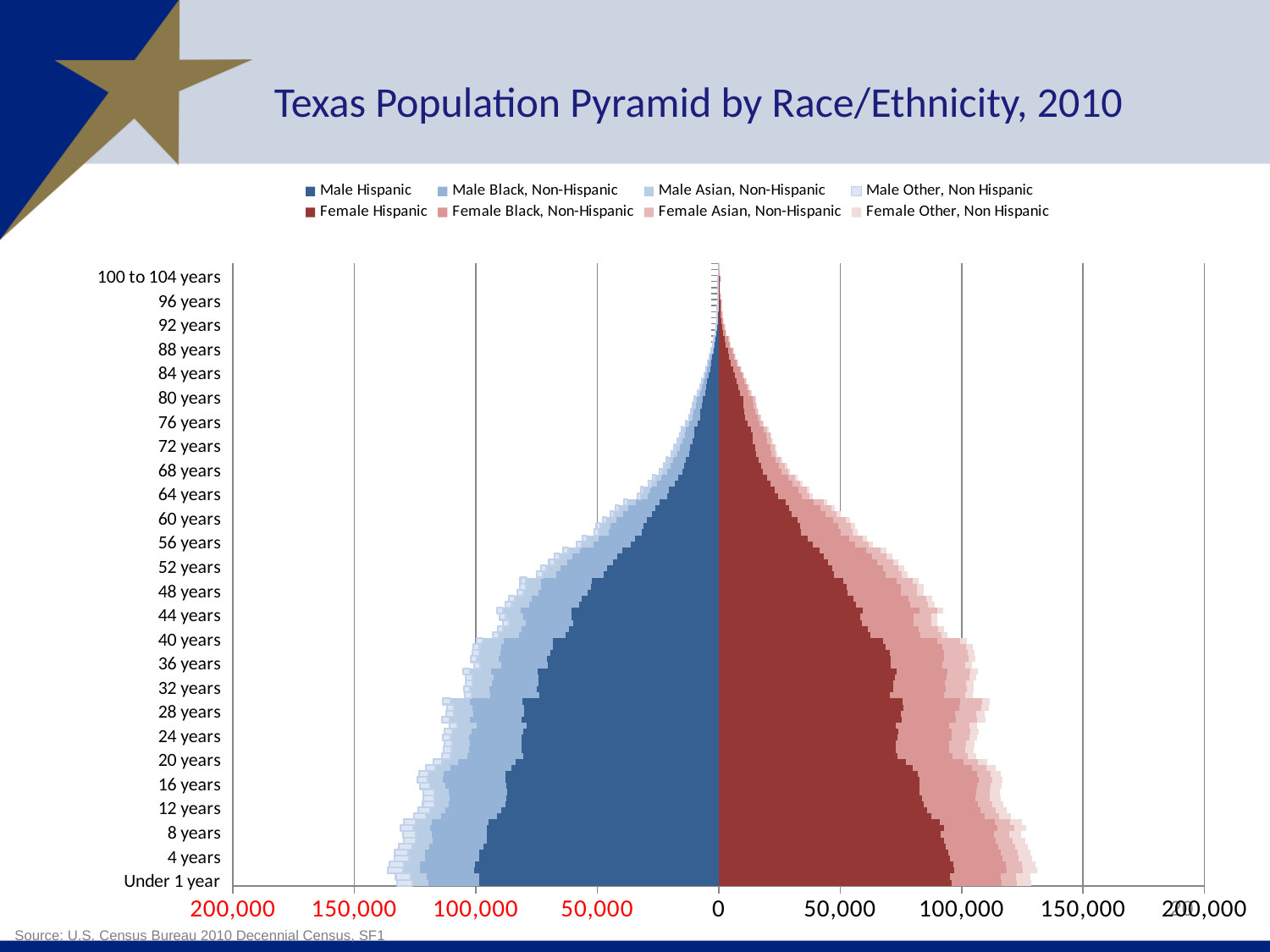
Do the bar lengths generally rise or fall as age increases from Under 1 year to 100 to 104 years? fall Is the total female bar for 80 years greater or less than 50,000? less What kind of chart is shown on the slide? Bar chart (population pyramid) Is the total female bar for Under 1 year greater or less than 100,000? greater On which side of the chart are the male series plotted? Left What is the title of the chart? Texas Population Pyramid by Race/Ethnicity, 2010 Is the total male bar for Under 1 year greater or less than 100,000? greater Which has a larger total male population, 40 years or 80 years? 40 years How many series does the legend list? 8